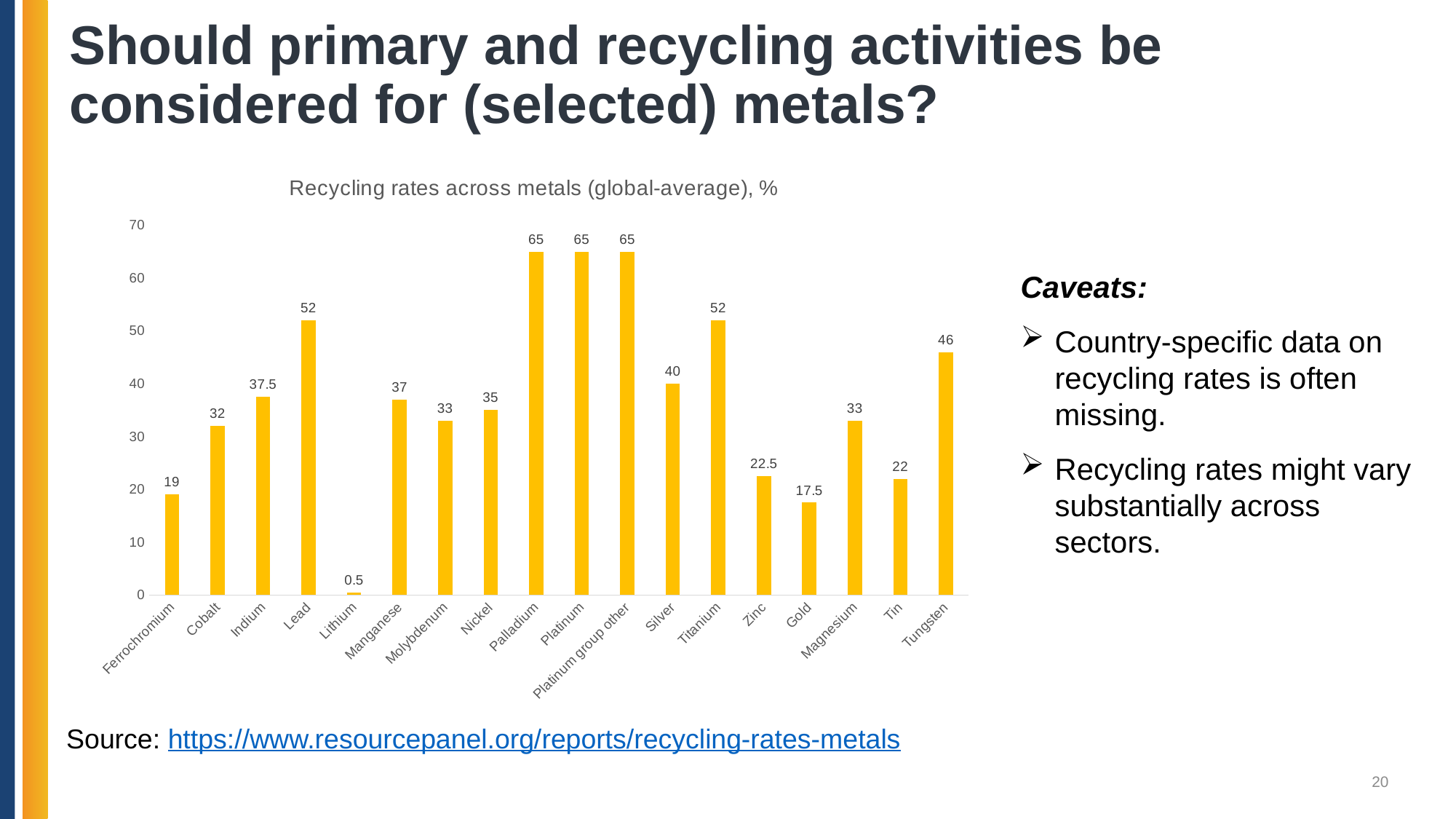
What is the title of the chart? Recycling rates across metals (global-average), % Which metal has the lowest recycling rate? Lithium What is the recycling rate for Indium? 37.5 What is the recycling rate for Tungsten? 46 Which has a higher recycling rate, Cobalt or Nickel? Nickel What is the difference between the recycling rates of Silver and Zinc? 17.5 How many metals are shown in the chart? 18 Is the recycling rate for Titanium greater or less than 50? greater What is the recycling rate for Gold? 17.5 What is the difference between the recycling rates of Palladium and Ferrochromium? 46 What is the recycling rate for Lead? 52 What kind of chart is shown on the slide? Bar chart